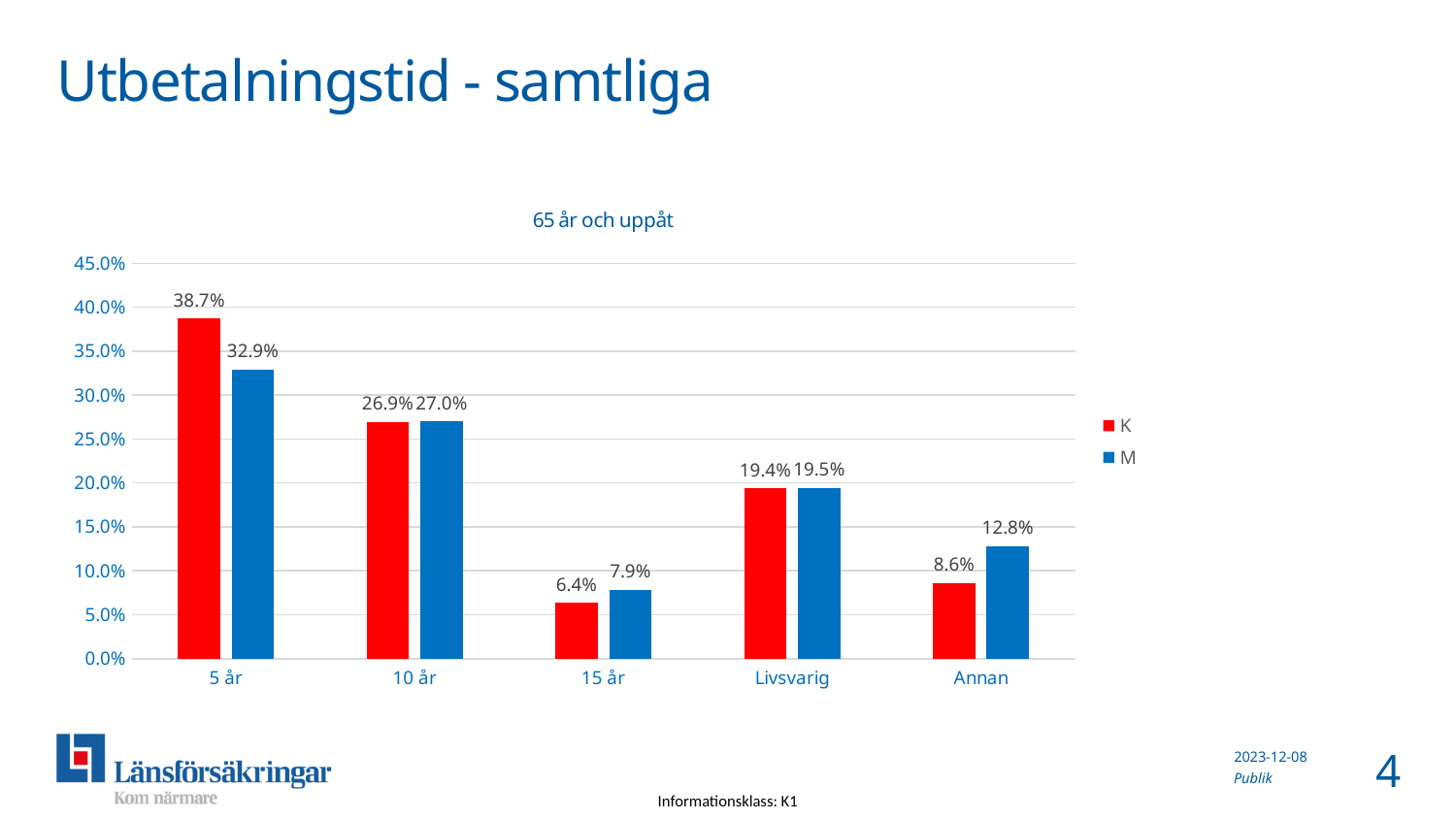
What is the value for K in the 5 år category? 38.7% What is the difference between K and M in the 5 år category? 5.8% What is the value for M in the 15 år category? 7.9% What is the value for M in the Annan category? 12.8% How many series does the legend list? 2 What is the difference between M and K in the Annan category? 4.2% Which category has the lowest value for M? 15 år How many categories are shown on the x axis? 5 Which category has the highest value for K? 5 år What kind of chart is shown on the slide? Bar chart Is the value for K in the Livsvarig category greater or less than 15.0%? greater Which is larger in the 15 år category, K or M? M